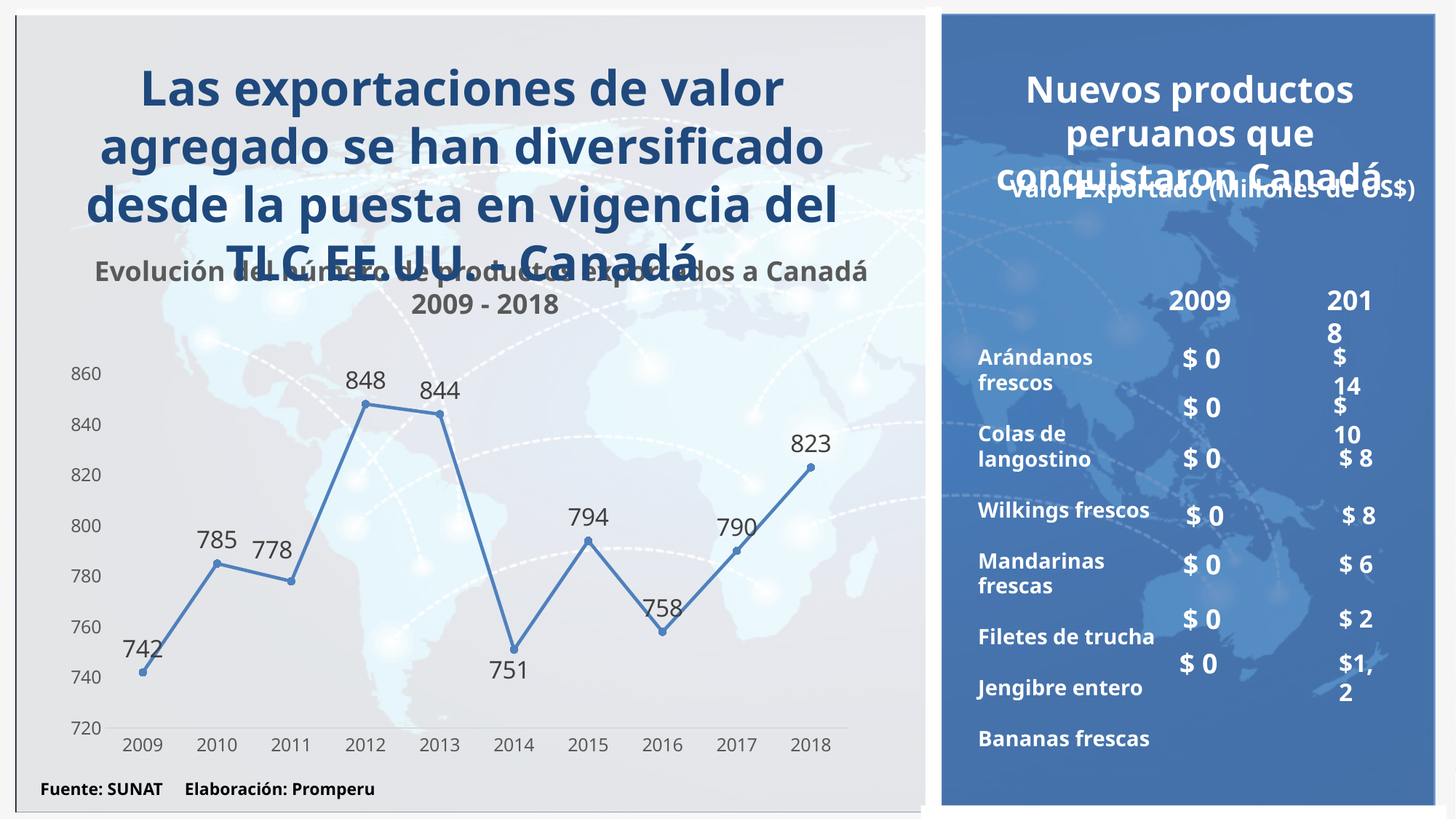
What was the number of products exported to Canada in 2018? 823 What is the title of the line chart? Evolución del número de productos exportados a Canadá 2009 - 2018 What is the difference between the number of products exported in 2018 and in 2017? 33 What is the difference between the number of products exported in 2012 and in 2009? 106 What was the number of products exported to Canada in 2009? 742 Did the number of products exported to Canada rise or fall from 2013 to 2014? Fall What was the number of products exported to Canada in 2012? 848 How many years are plotted on the line chart? 10 In which year was the number of products exported to Canada highest? 2012 Which year had more products exported to Canada, 2014 or 2016? 2016 What type of chart is used to show the evolution of the number of products exported to Canada? Line chart In which year was the number of products exported to Canada lowest? 2009